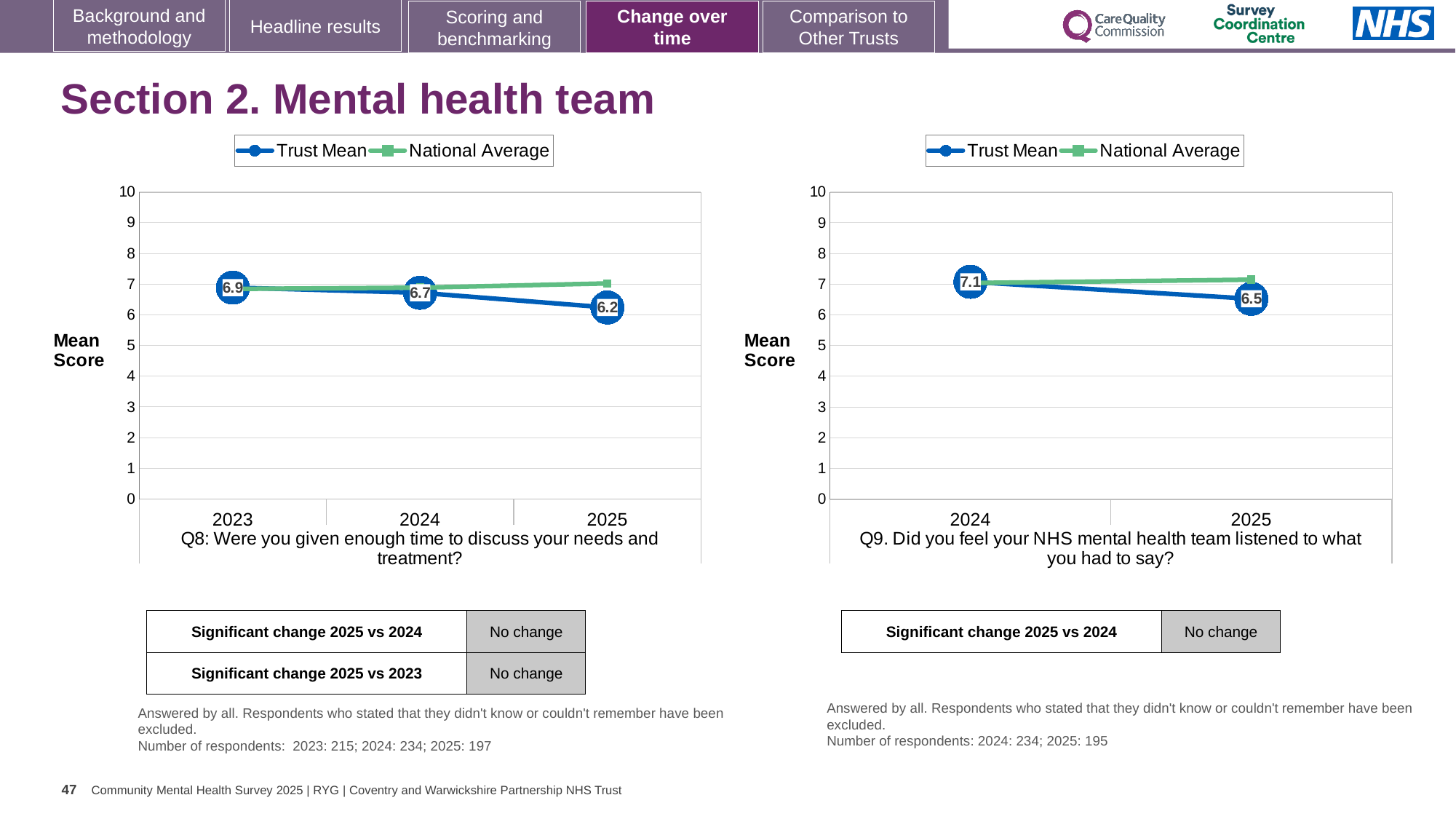
In the Q8 chart on the left, what is the Trust Mean for 2023? 6.9 In the Q9 chart on the right, by how much did the Trust Mean change from 2024 to 2025? 0.6 In the Q8 chart on the left, what is the Trust Mean for 2025? 6.2 In the Q8 chart on the left, is the Trust Mean for 2025 higher or lower than the National Average for 2025? lower In the Q8 chart on the left, what is the difference between the Trust Mean for 2023 and 2025? 0.7 In the Q8 chart on the left, does the Trust Mean rise or fall from 2023 to 2025? fall In the Q9 chart on the right, is the National Average for 2025 greater or less than 6? greater In the Q8 chart on the left, which year has the lowest Trust Mean? 2025 How many years are shown on the x axis of the Q9 chart on the right? 2 In the Q9 chart on the right, what is the Trust Mean for 2025? 6.5 In the Q8 chart on the left, which year has the highest Trust Mean? 2023 In the Q9 chart on the right, what is the Trust Mean for 2024? 7.1